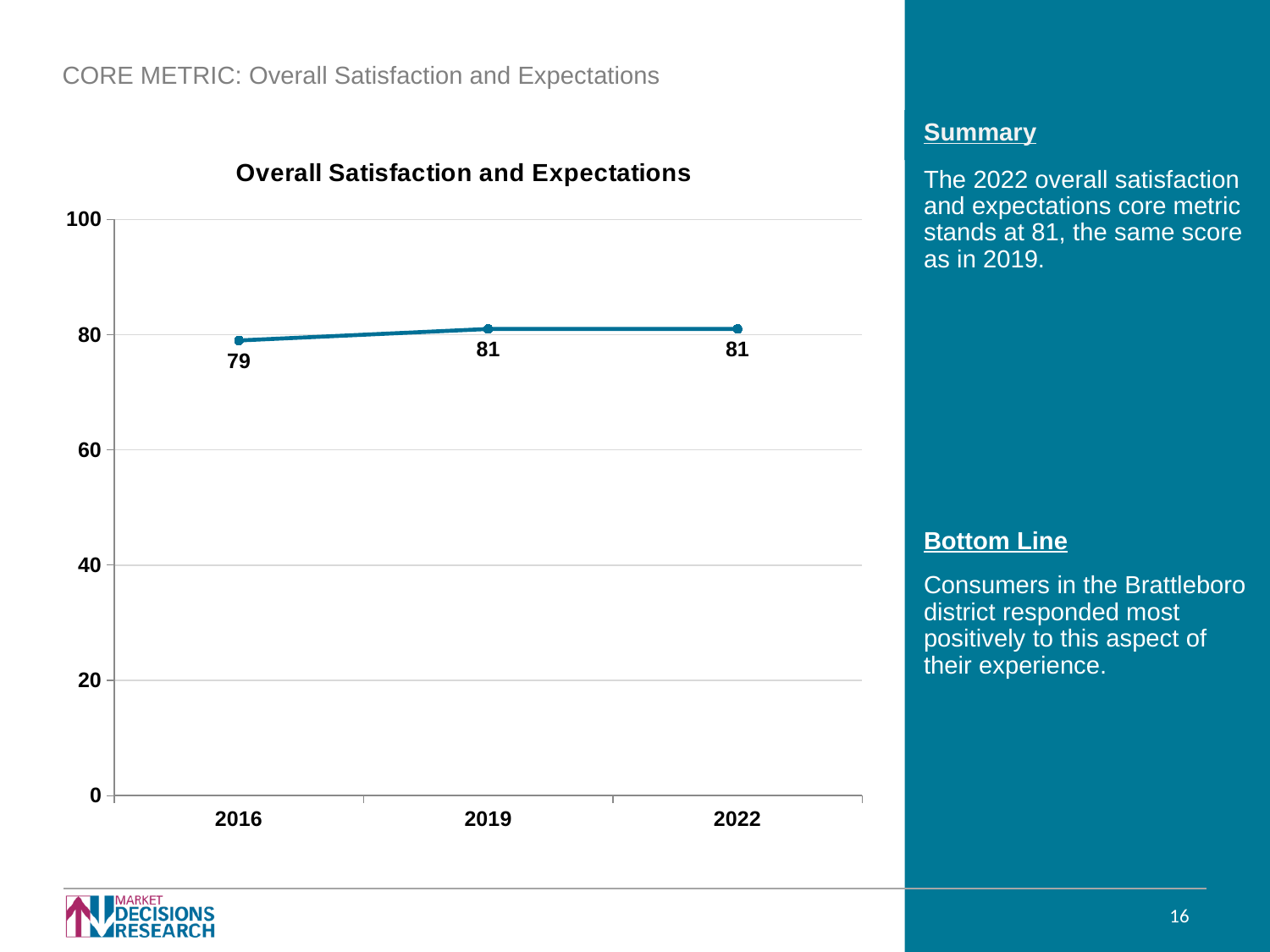
Which year has the lowest value? 2016 Which is larger, the value for 2016 or the value for 2022? 2022 How many years are plotted on the chart? 3 What is the value for 2016? 79 What is the value for 2022? 81 Do the values rise or fall from 2016 to 2019? rise What is the title of the chart? Overall Satisfaction and Expectations Is the value for 2016 greater or less than 60? greater What kind of chart is shown? line chart Is the value for 2022 greater or less than 100? less What is the value for 2019? 81 What is the difference between the values for 2019 and 2016? 2